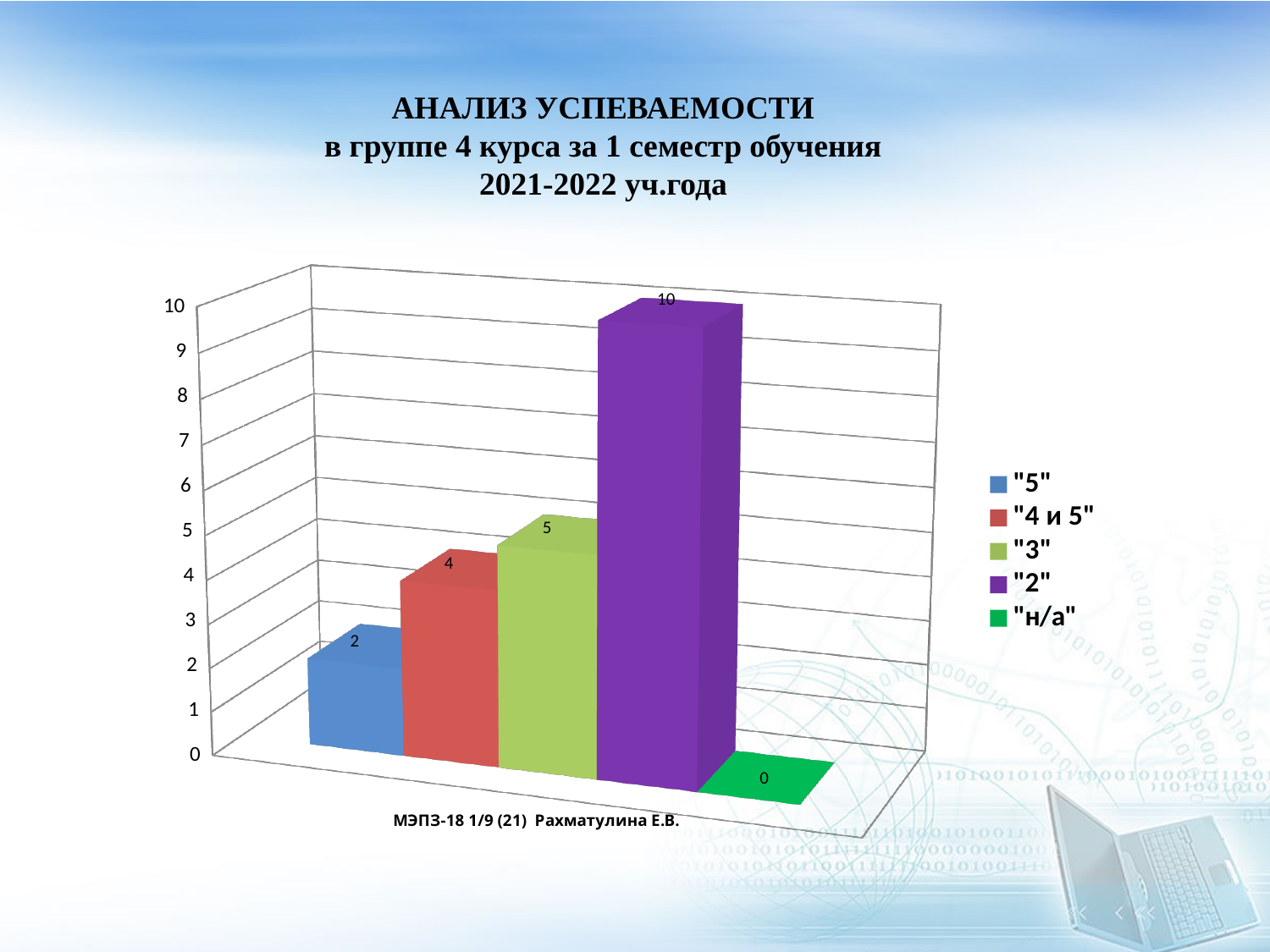
What is the value for "2"? 10 How many series does the legend list? 5 What is the difference between the values for "2" and "3"? 5 What is the value for "3"? 5 Which is larger, the value for "4 и 5" or the value for "5"? "4 и 5" Which category has the highest value? "2" What is the value for "4 и 5"? 4 What kind of chart is shown on the slide? bar chart What is the value for "5"? 2 Which category has the lowest value? "н/а" What is the label printed below the chart? МЭПЗ-18 1/9 (21) Рахматулина Е.В. What is the value for "н/а"? 0